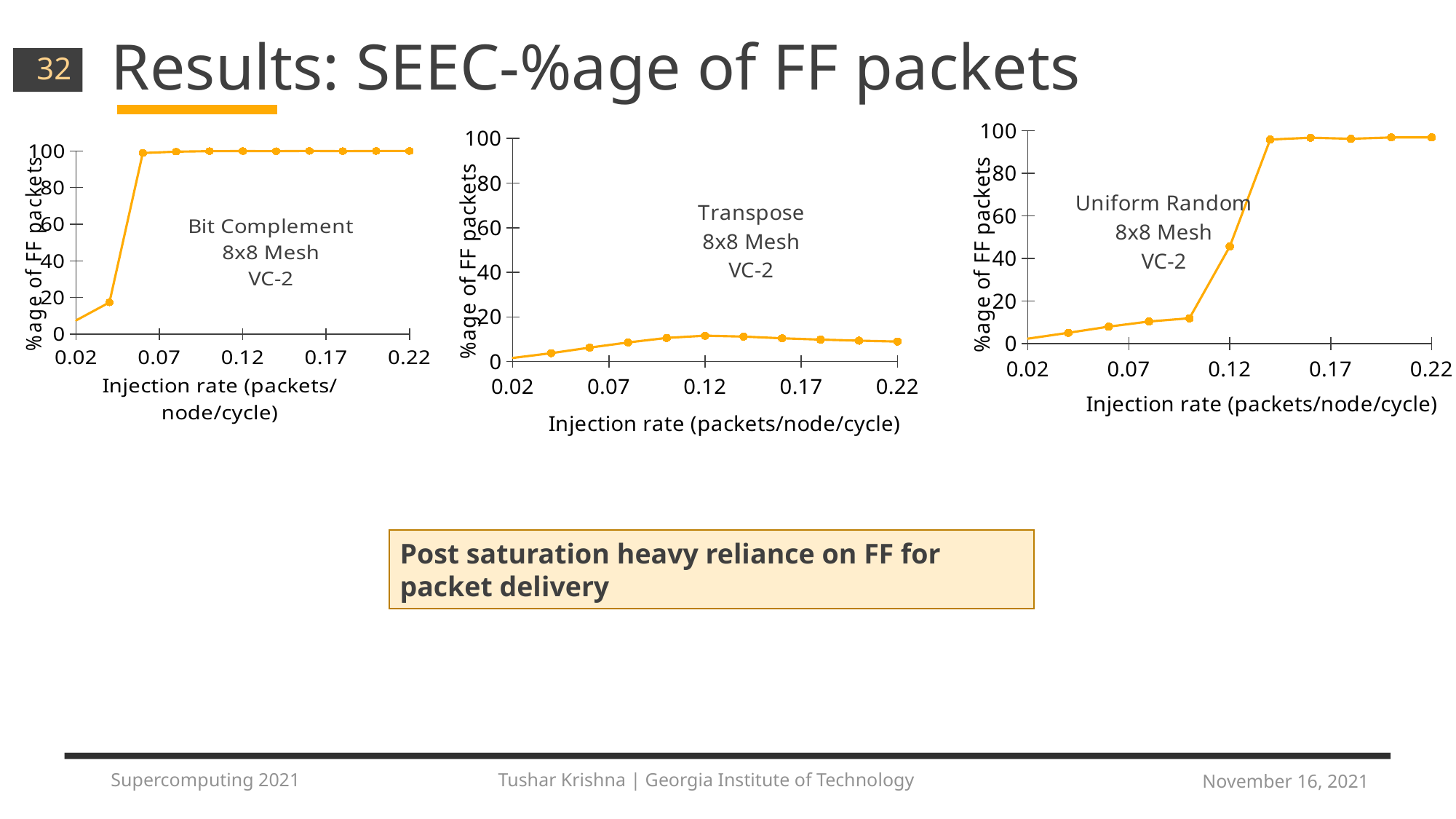
At injection rate 0.22, which chart shows the larger %age of FF packets: Bit Complement or Transpose? Bit Complement How many data points are plotted on the Transpose chart in the middle? 11 What kind of chart is the Bit Complement chart on the left? line chart On the Transpose chart, is the value at injection rate 0.12 greater or less than 20? less What mesh size and VC configuration is annotated on the Transpose chart? 8x8 Mesh, VC-2 On the Bit Complement chart, is the value at injection rate 0.02 greater or less than 20? less What is the x-axis label on the Uniform Random chart? Injection rate (packets/node/cycle) On the Uniform Random chart, is the value at injection rate 0.22 greater or less than 80? greater On the Uniform Random chart, does the %age of FF packets generally rise or fall as the injection rate increases? rise What is the highest tick value shown on the y-axis of the Bit Complement chart? 100